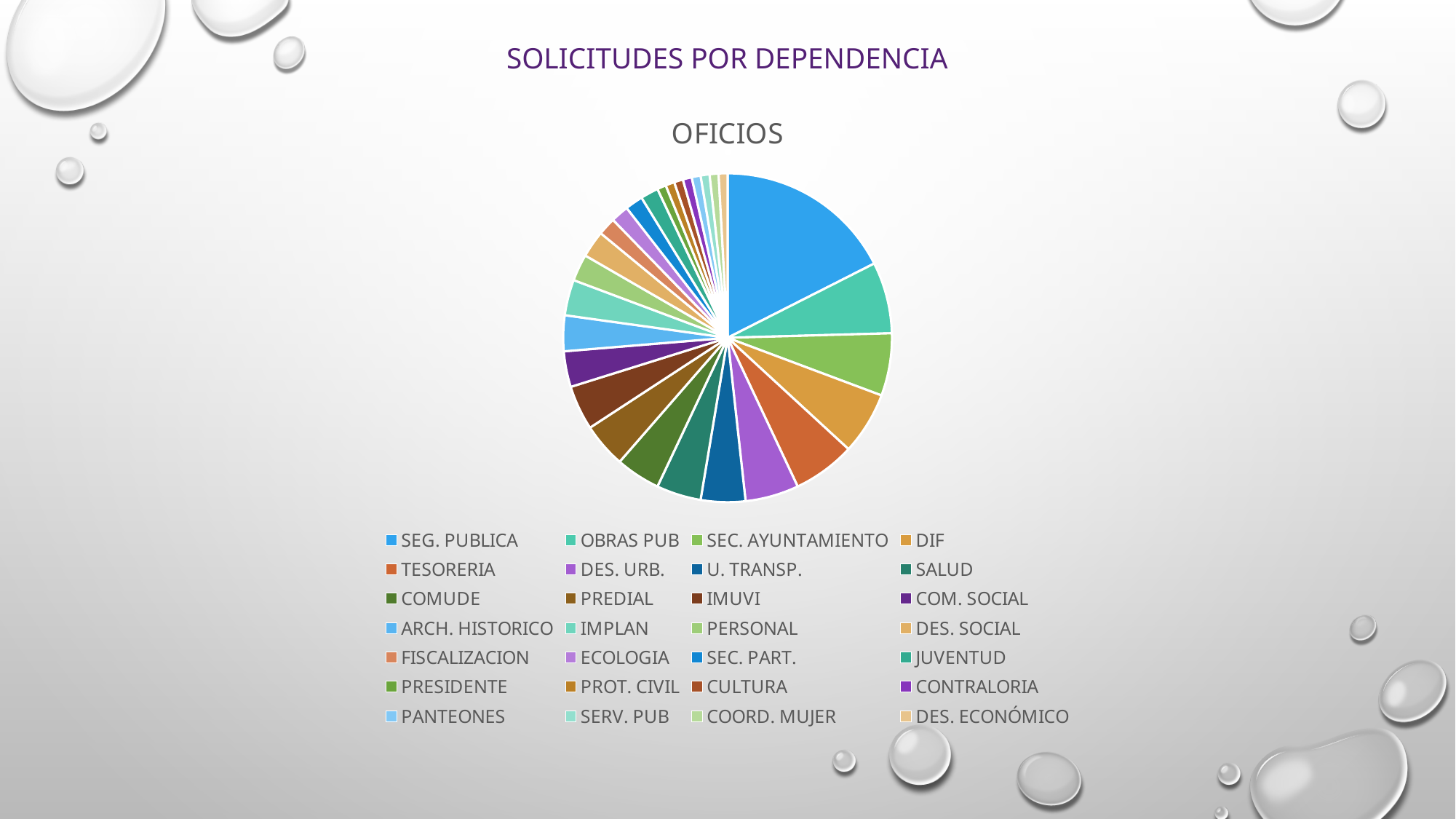
What kind of chart is shown on the slide? pie chart Which slice is larger, SEG. PUBLICA or OBRAS PUB? SEG. PUBLICA What colour is the SEG. PUBLICA slice in the pie chart? blue Which slice is larger, SEG. PUBLICA or DIF? SEG. PUBLICA Which slice is larger, OBRAS PUB or PANTEONES? OBRAS PUB What is the title of the chart? OFICIOS How many categories does the legend of the pie chart list? 28 Which category has the largest slice of the pie chart? SEG. PUBLICA